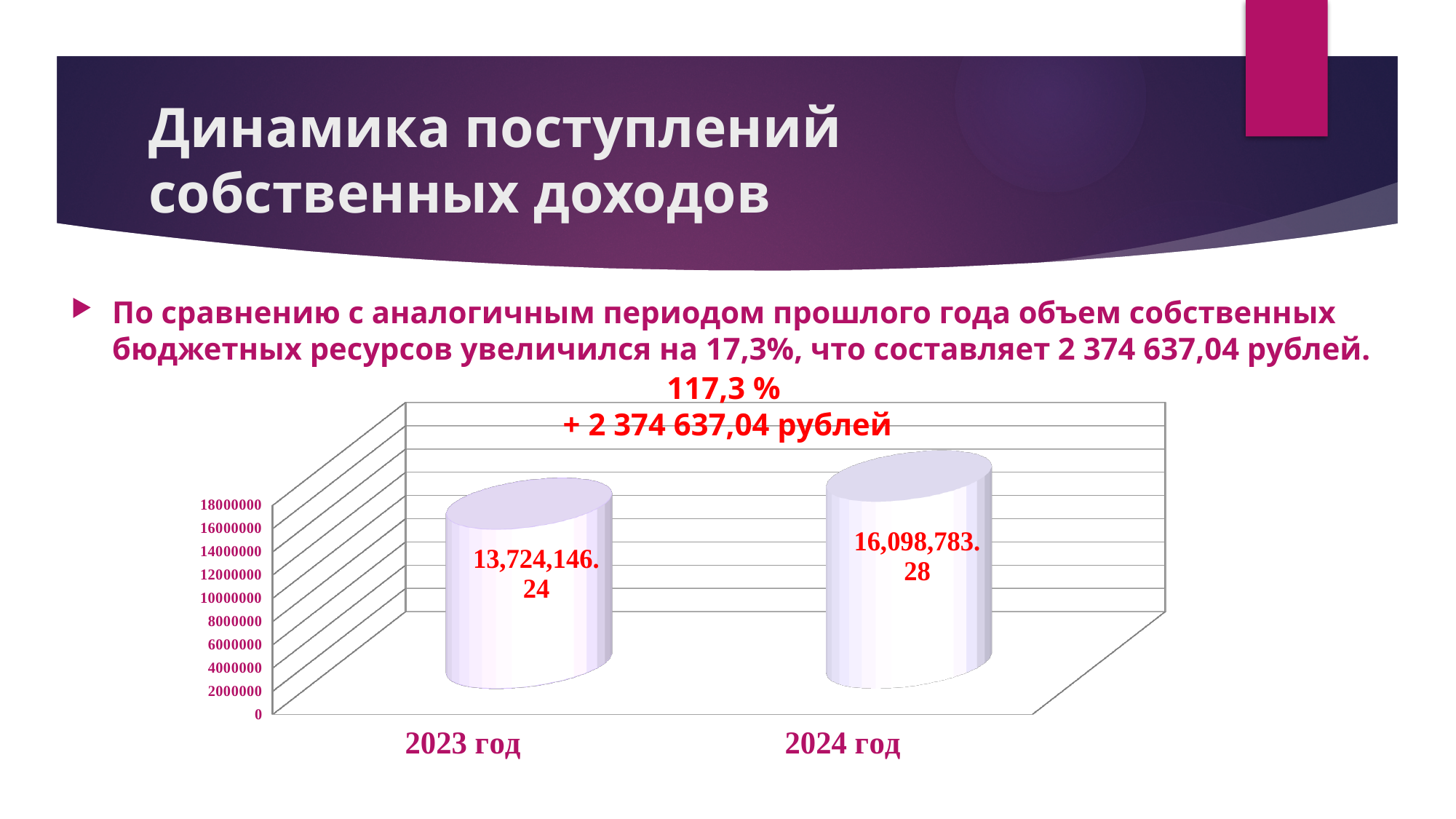
What is the value for 2023 год? 13,724,146.24 What kind of chart is shown on the slide? bar chart Which year has the lower value? 2023 год Which year has the higher value? 2024 год Is the value for 2024 год greater or less than 18000000? less What percentage is printed in red above the chart? 117,3 % What is the value for 2024 год? 16,098,783.28 Is the value for 2024 год larger or smaller than the value for 2023 год? larger Is the value for 2023 год greater or less than 12000000? greater What is the difference between the values for 2024 год and 2023 год? 2,374,637.04 Do the values rise or fall from 2023 год to 2024 год? rise How many categories are shown on the x axis? 2